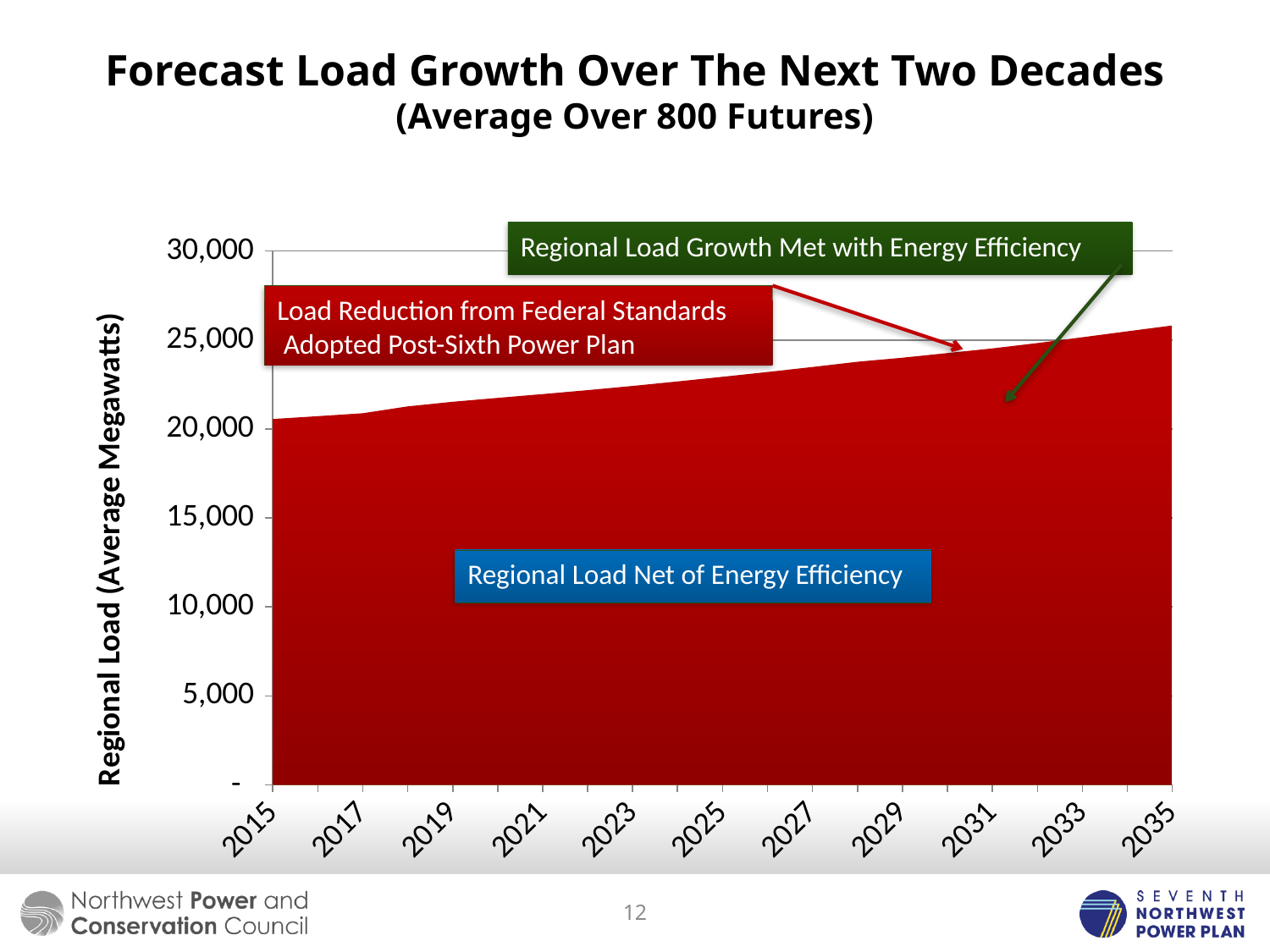
Which year shown on the x axis has the lowest regional load? 2015 What label is shown in the blue box inside the shaded area? Regional Load Net of Energy Efficiency How many year labels are shown on the x axis? 11 Which year shown on the x axis has the highest regional load? 2035 What is the title of the y axis? Regional Load (Average Megawatts) Is the regional load value for 2015 greater or less than 20,000? greater Is the regional load value for 2035 greater or less than 25,000? greater Which year has the higher regional load, 2015 or 2035? 2035 What kind of chart is shown on the slide? area chart Is the regional load value for 2035 greater or less than 30,000? less Do the regional load values rise or fall from 2015 to 2035? rise